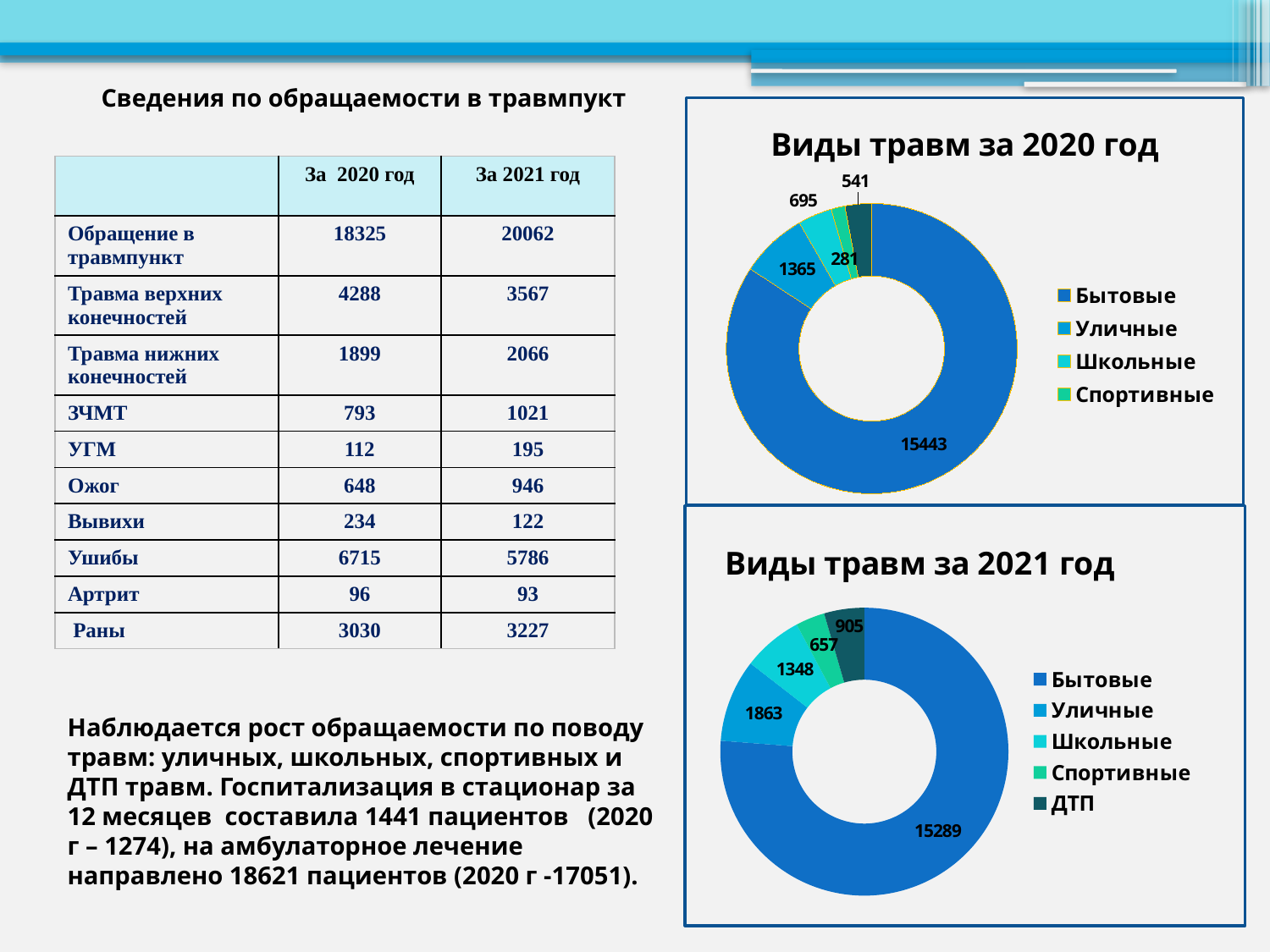
In the chart 'Виды травм за 2021 год', which category has the lowest value? Спортивные What type of chart is 'Виды травм за 2021 год'? Doughnut chart In the chart 'Виды травм за 2021 год', what is the difference between Уличные and Школьные? 515 How many entries does the legend of the chart 'Виды травм за 2021 год' list? 5 In the chart 'Виды травм за 2020 год', what is the value for Школьные? 695 How many entries does the legend of the chart 'Виды травм за 2020 год' list? 4 In the chart 'Виды травм за 2021 год', which category has the highest value? Бытовые In the chart 'Виды травм за 2020 год', which category has the lowest value? Спортивные Which is larger: Уличные in the chart 'Виды травм за 2020 год' or Уличные in the chart 'Виды травм за 2021 год'? 2021 (1863) In the chart 'Виды травм за 2021 год', what is the value for ДТП? 905 In the chart 'Виды травм за 2020 год', what is the value for Бытовые? 15443 In the chart 'Виды травм за 2021 год', what is the value for Уличные? 1863